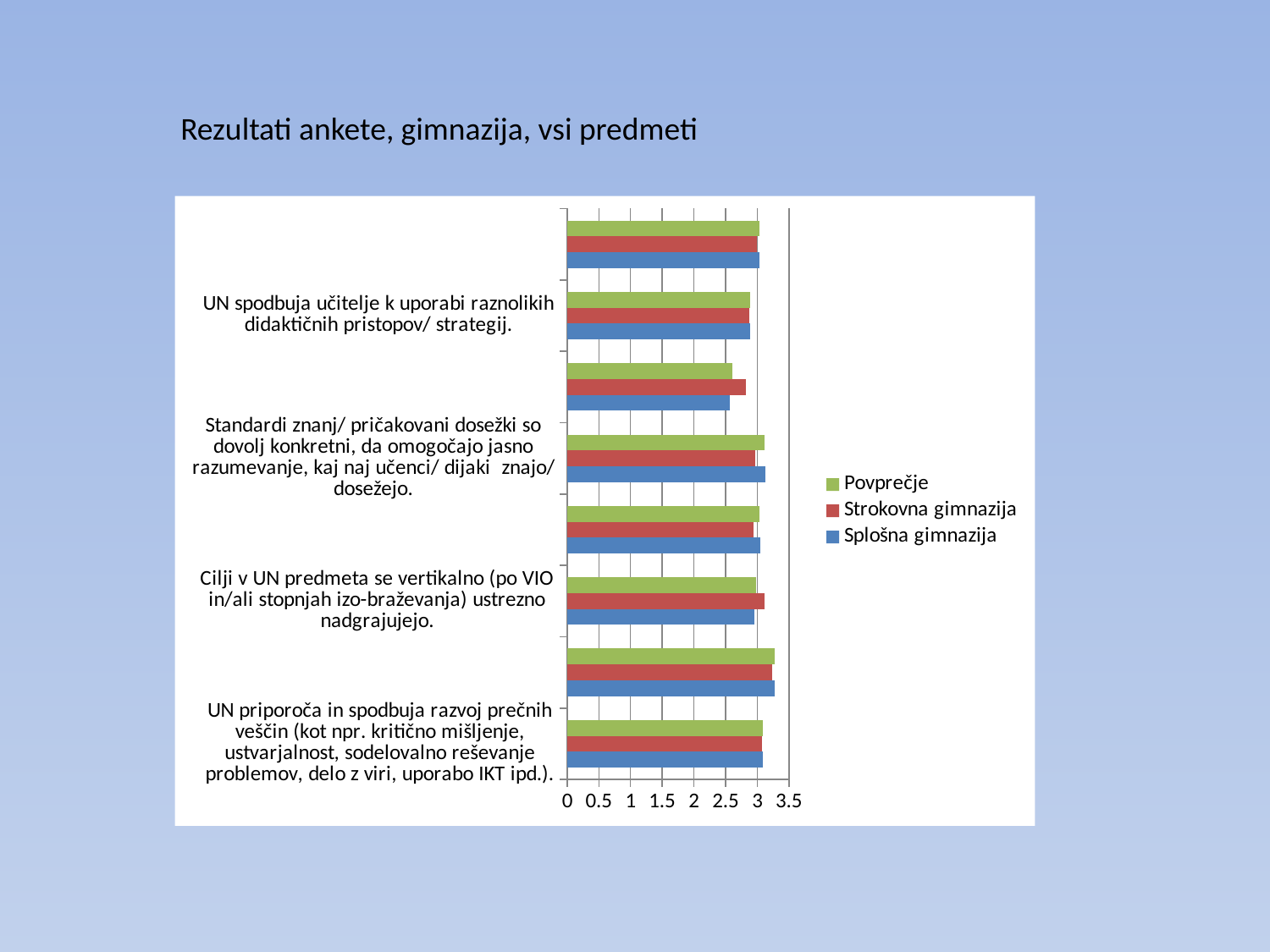
Is the Povprečje value for 'Standardi znanj/ pričakovani dosežki so dovolj konkretni, da omogočajo jasno razumevanje, kaj naj učenci/ dijaki znajo/ dosežejo.' greater or less than 2.5? greater What is the highest value shown on the horizontal axis? 3.5 Is the Splošna gimnazija value for 'UN priporoča in spodbuja razvoj prečnih veščin (kot npr. kritično mišljenje, ustvarjalnost, sodelovalno reševanje problemov, delo z viri, uporabo IKT ipd.).' greater or less than 3.5? less What are the three series listed in the legend? Povprečje, Strokovna gimnazija, Splošna gimnazija Is the Strokovna gimnazija value for 'Cilji v UN predmeta se vertikalno (po VIO in/ali stopnjah izo-braževanja) ustrezno nadgrajujejo.' greater or less than 2.5? greater What is the title of the slide containing the chart? Rezultati ankete, gimnazija, vsi predmeti How many series does the legend list? 3 How many groups of bars are plotted in the chart? 8 What kind of chart is shown on the slide? Bar chart